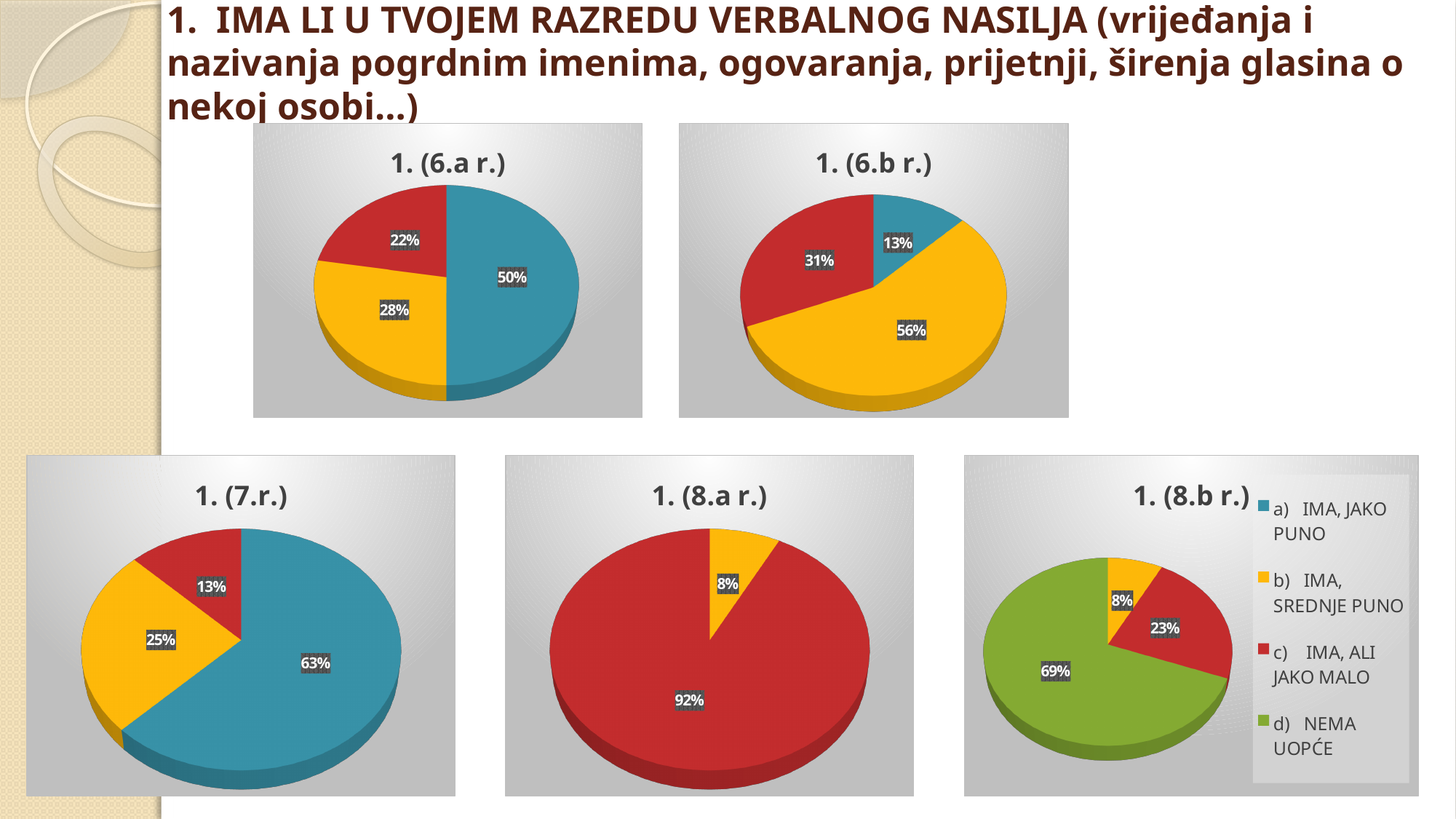
In the chart titled "1. (6.b r.)", which is larger: "a) IMA, JAKO PUNO" or "c) IMA, ALI JAKO MALO"? c) IMA, ALI JAKO MALO How many slices does the chart titled "1. (8.b r.)" have? 3 In the chart titled "1. (8.a r.)", which category has the largest slice? c) IMA, ALI JAKO MALO How many slices does the chart titled "1. (8.a r.)" have? 2 In the chart titled "1. (8.b r.)", which category has the smallest slice? b) IMA, SREDNJE PUNO In the chart titled "1. (6.a r.)", what is the difference between the "b) IMA, SREDNJE PUNO" and "c) IMA, ALI JAKO MALO" slices? 6% In the chart titled "1. (8.b r.)", what percentage is shown for "d) NEMA UOPĆE"? 69% In the chart titled "1. (6.a r.)", what percentage is shown for "a) IMA, JAKO PUNO"? 50% In the chart titled "1. (6.b r.)", what percentage is shown for "b) IMA, SREDNJE PUNO"? 56% What type of chart is the chart titled "1. (7.r.)"? Pie chart In the chart titled "1. (7.r.)", what percentage is shown for "c) IMA, ALI JAKO MALO"? 13% How many entries does the legend on the slide list? 4